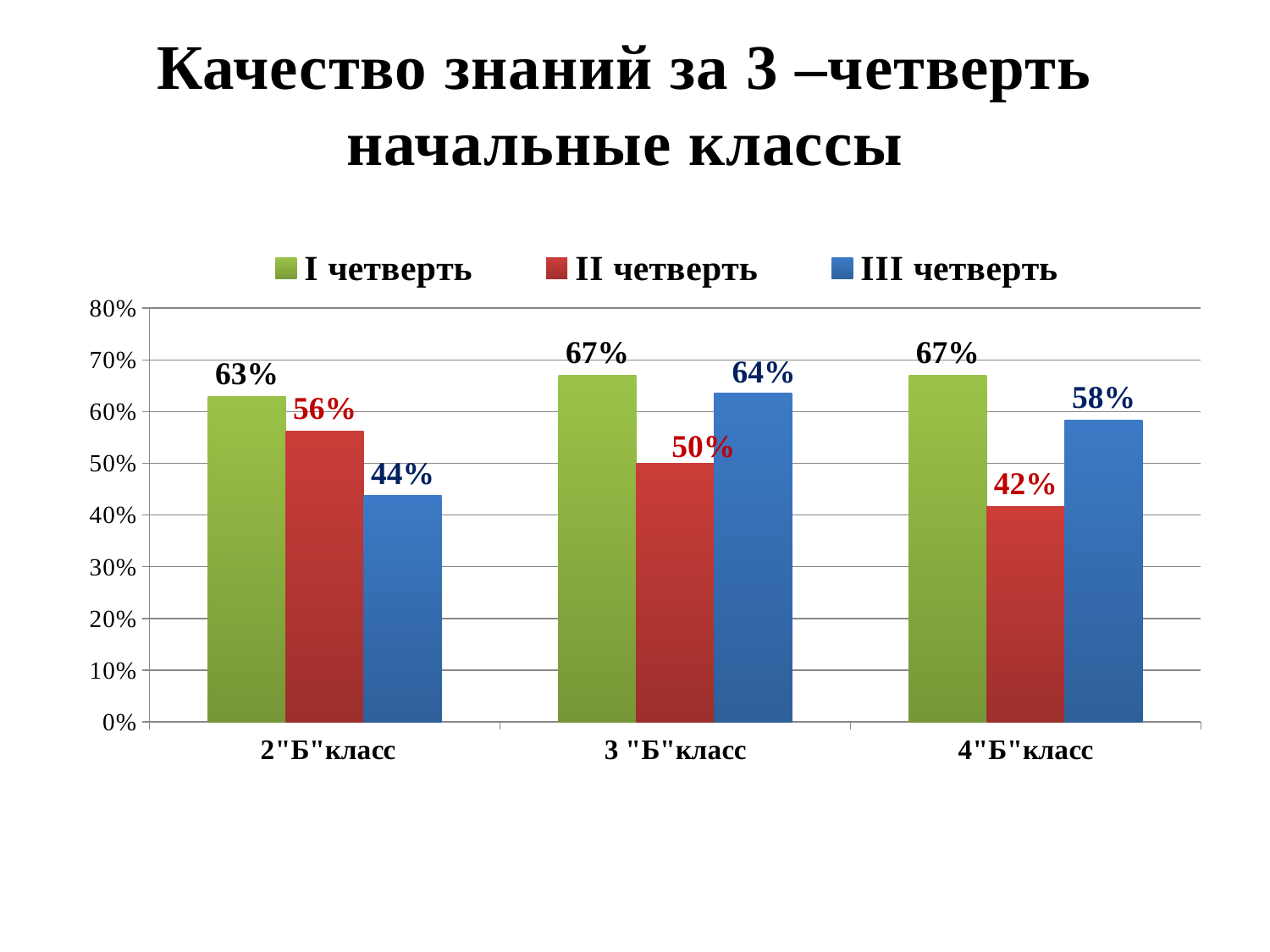
How many series does the legend list? 3 What is the difference between the III четверть values for 3 "Б"класс and 2"Б"класс? 20% Which is larger for 3 "Б"класс: the II четверть value or the III четверть value? III четверть What is the difference between the I четверть and II четверть values for 4"Б"класс? 25% Which class has the highest value for II четверть? 2"Б"класс What is the value for II четверть for 4"Б"класс? 42% What kind of chart is shown on the slide? Bar chart How many classes are shown on the x axis? 3 What is the value for III четверть for 2"Б"класс? 44% Which class has the lowest value for III четверть? 2"Б"класс What colour are the bars for II четверть? Red What is the value for I четверть for 3 "Б"класс? 67%